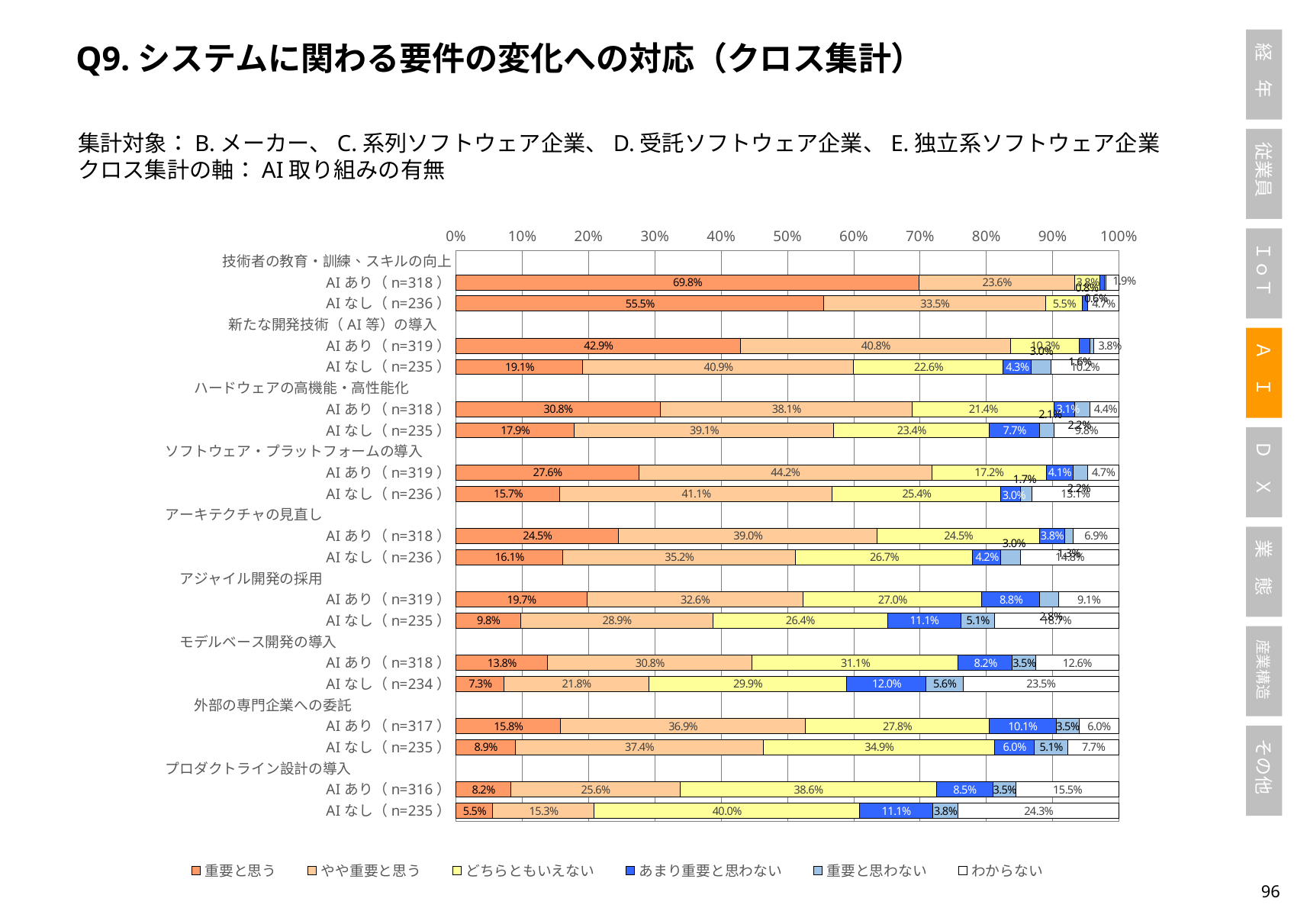
What is the どちらともいえない value for プロダクトライン設計の導入 AIなし (n=235)? 40.0% Which bar has the lowest 重要と思う value? プロダクトライン設計の導入 AIなし (n=235) What is the わからない value for モデルベース開発の導入 AIなし (n=234)? 23.5% What is the last entry in the chart legend? わからない What is the 重要と思う value for 技術者の教育・訓練、スキルの向上 AIあり (n=318)? 69.8% How many series does the legend list? 6 For 外部の専門企業への委託, which has the larger 重要と思う value: AIあり (n=317) or AIなし (n=235)? AIあり (n=317) What is the やや重要と思う value for 新たな開発技術（AI等）の導入 AIなし (n=235)? 40.9% Which bar has the highest 重要と思う value? 技術者の教育・訓練、スキルの向上 AIあり (n=318) How many bars (AIあり/AIなし rows) are plotted in the chart? 20 What kind of chart is shown on the slide? Stacked bar chart What is the difference in the 重要と思う value between AIあり (n=318) and AIなし (n=236) for 技術者の教育・訓練、スキルの向上? 14.3 percentage points